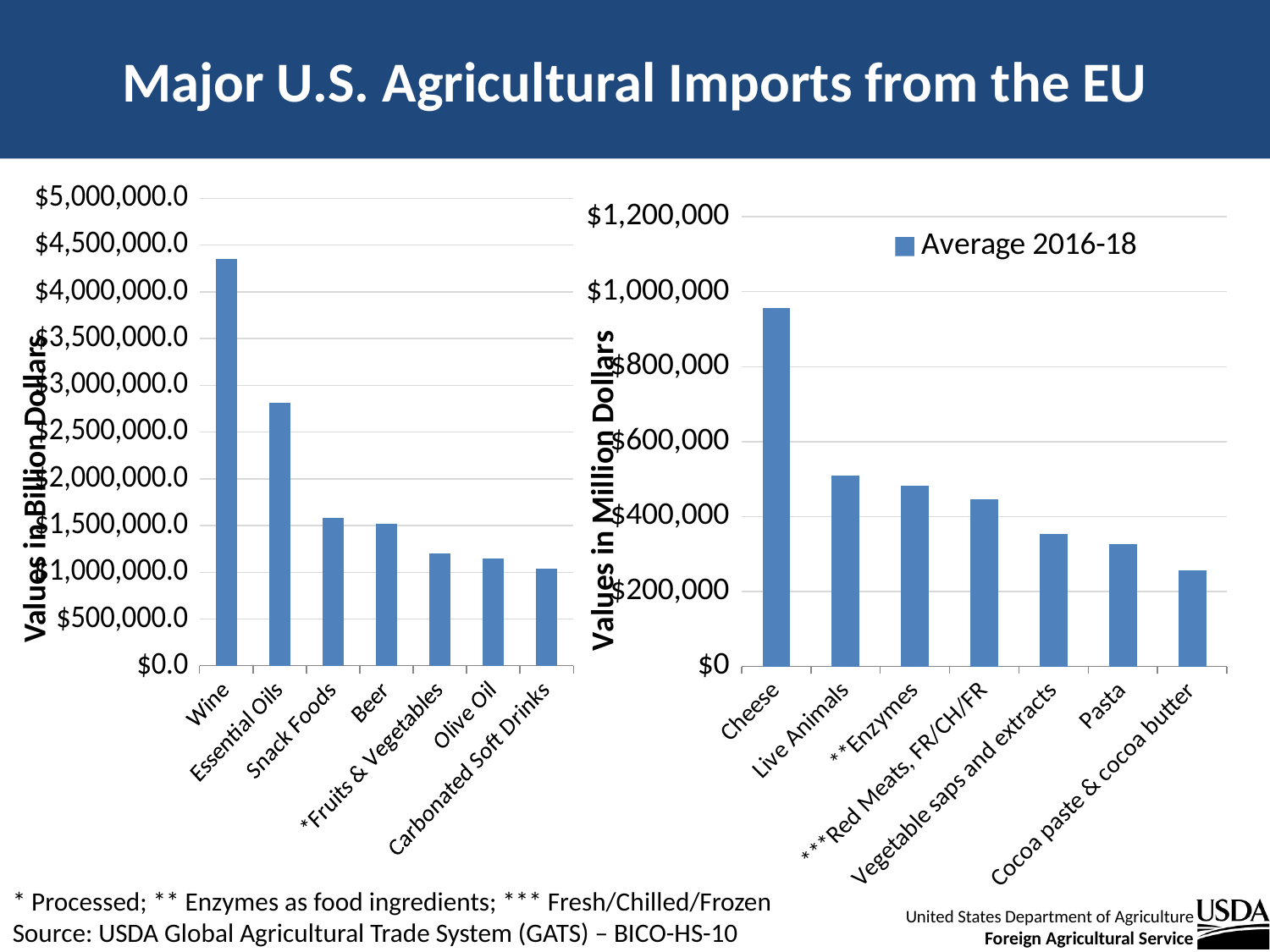
In the left chart (Values in Billion Dollars), which category has the highest value? Wine In the left chart (Values in Billion Dollars), is the value for Essential Oils greater or less than $3,000,000.0? less In the left chart (Values in Billion Dollars), which category has the lowest value? Carbonated Soft Drinks In the right chart (Values in Million Dollars), which is larger, the value for Live Animals or the value for Vegetable saps and extracts? Live Animals In the left chart (Values in Billion Dollars), do the values rise or fall from left to right along the x axis? fall In the right chart (Values in Million Dollars), what series name does the legend show? Average 2016-18 In the right chart (Values in Million Dollars), is the value for Pasta greater or less than $400,000? less In the right chart (Values in Million Dollars), which category has the highest value? Cheese In the right chart (Values in Million Dollars), is the value for Cheese greater or less than $800,000? greater In the left chart (Values in Billion Dollars), how many categories are plotted? 7 In the right chart (Values in Million Dollars), which category has the lowest value? Cocoa paste & cocoa butter